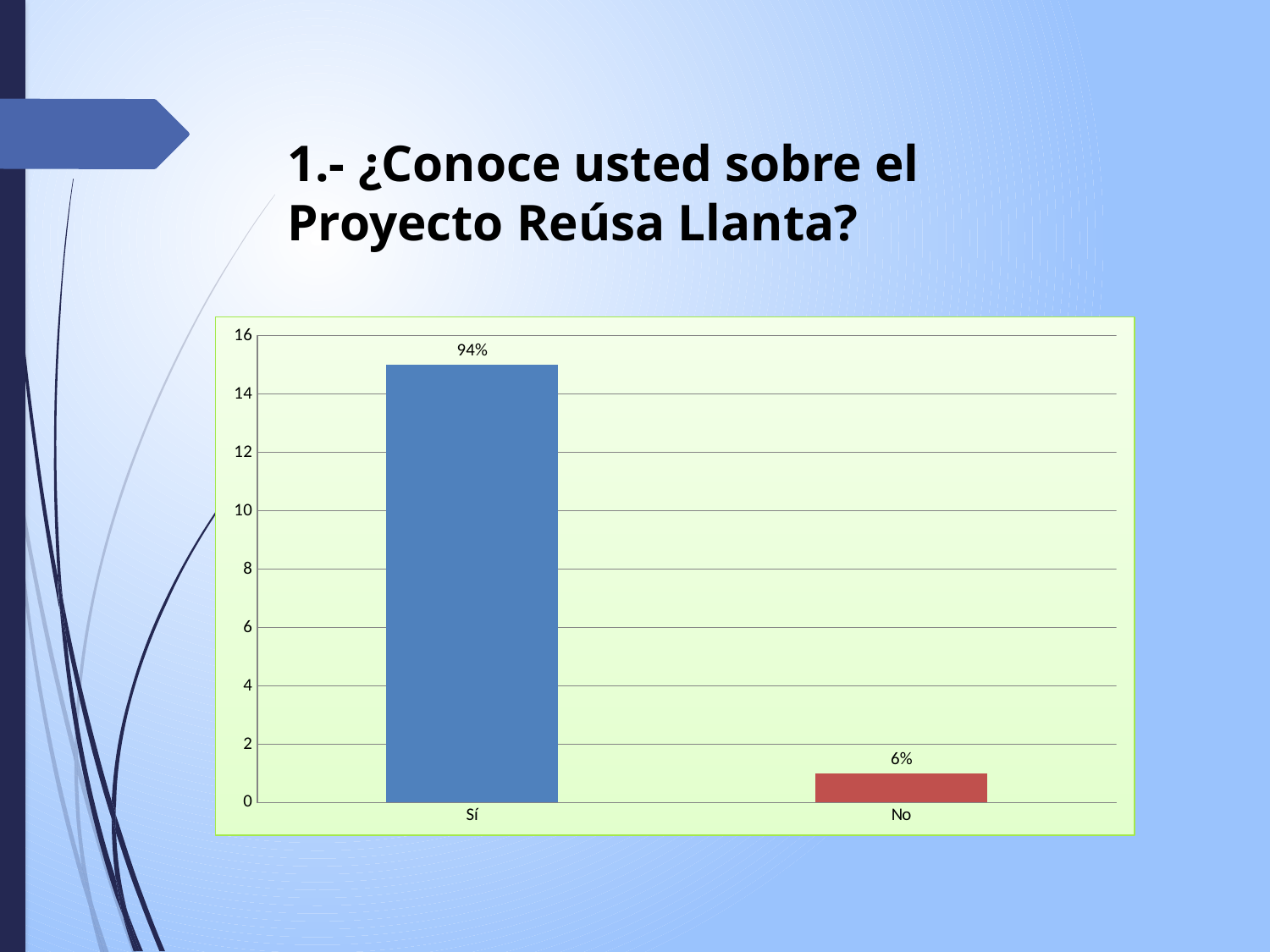
What colour is the bar for No? Red What data label is shown on the bar for Sí? 94% What data label is shown on the bar for No? 6% Which category has the lowest bar? No What is the highest value shown on the vertical axis of the chart? 16 What is the difference between the data labels for Sí and No? 88% Which is larger, the bar for Sí or the bar for No? Sí Is the value for No greater or less than 2 on the vertical axis? less What kind of chart is shown on the slide? Bar chart Which category has the highest bar? Sí How many categories are shown on the x axis of the chart? 2 Is the value for Sí greater or less than 14 on the vertical axis? greater